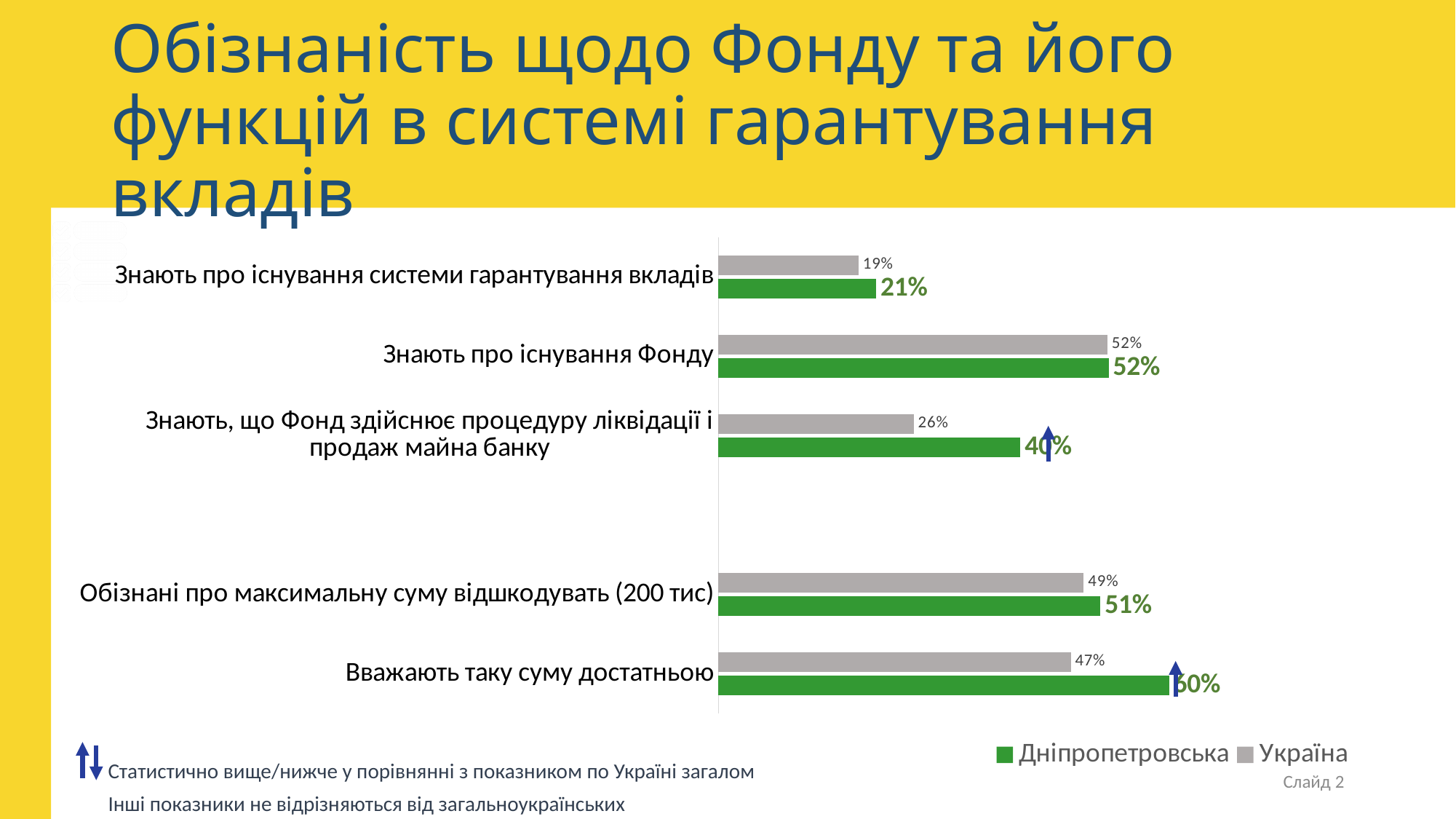
What is the value for Дніпропетровська in the category "Знають про існування системи гарантування вкладів"? 21% How many categories are shown in the chart? 5 What is the value for Дніпропетровська in the category "Обізнані про максимальну суму відшкодувать (200 тис)"? 51% For "Знають, що Фонд здійснює процедуру ліквідації і продаж майна банку", which series has the larger value, Дніпропетровська or Україна? Дніпропетровська Which category has the highest value for the Дніпропетровська series? Вважають таку суму достатньою What is the value for Україна in the category "Знають про існування системи гарантування вкладів"? 19% What is the value for Дніпропетровська in the category "Знають про існування Фонду"? 52% What is the value for Україна in the category "Знають, що Фонд здійснює процедуру ліквідації і продаж майна банку"? 26% What is the value for Україна in the category "Вважають таку суму достатньою"? 47% Which category has the lowest value for the Україна series? Знають про існування системи гарантування вкладів How many series does the legend list? 2 What is the difference between the Дніпропетровська and Україна values for "Обізнані про максимальну суму відшкодувать (200 тис)"? 2 percentage points